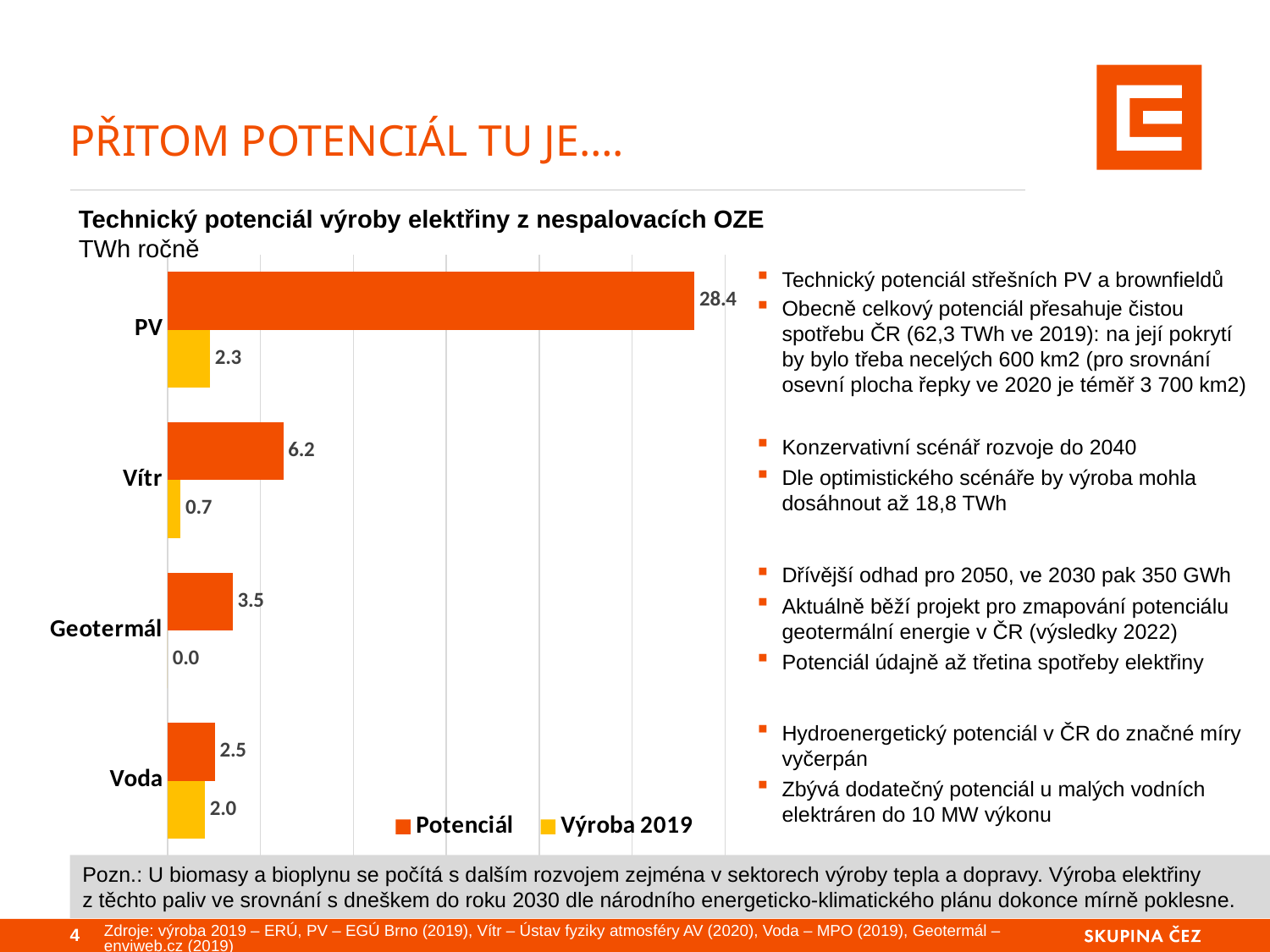
What is the Potenciál value for Voda? 2.5 What kind of chart is shown on the slide? Bar chart What is the Potenciál value for PV? 28.4 What is the title of the chart? Technický potenciál výroby elektřiny z nespalovacích OZE Which is larger: the Potenciál value for Vítr or the Potenciál value for Geotermál? Vítr Which category has the lowest Výroba 2019 value? Geotermál How many categories are shown on the chart? 4 How many series does the legend list? 2 What is the Výroba 2019 value for Geotermál? 0.0 Which category has the highest Potenciál value? PV What is the Výroba 2019 value for Vítr? 0.7 What is the difference between the Potenciál and Výroba 2019 values for PV? 26.1